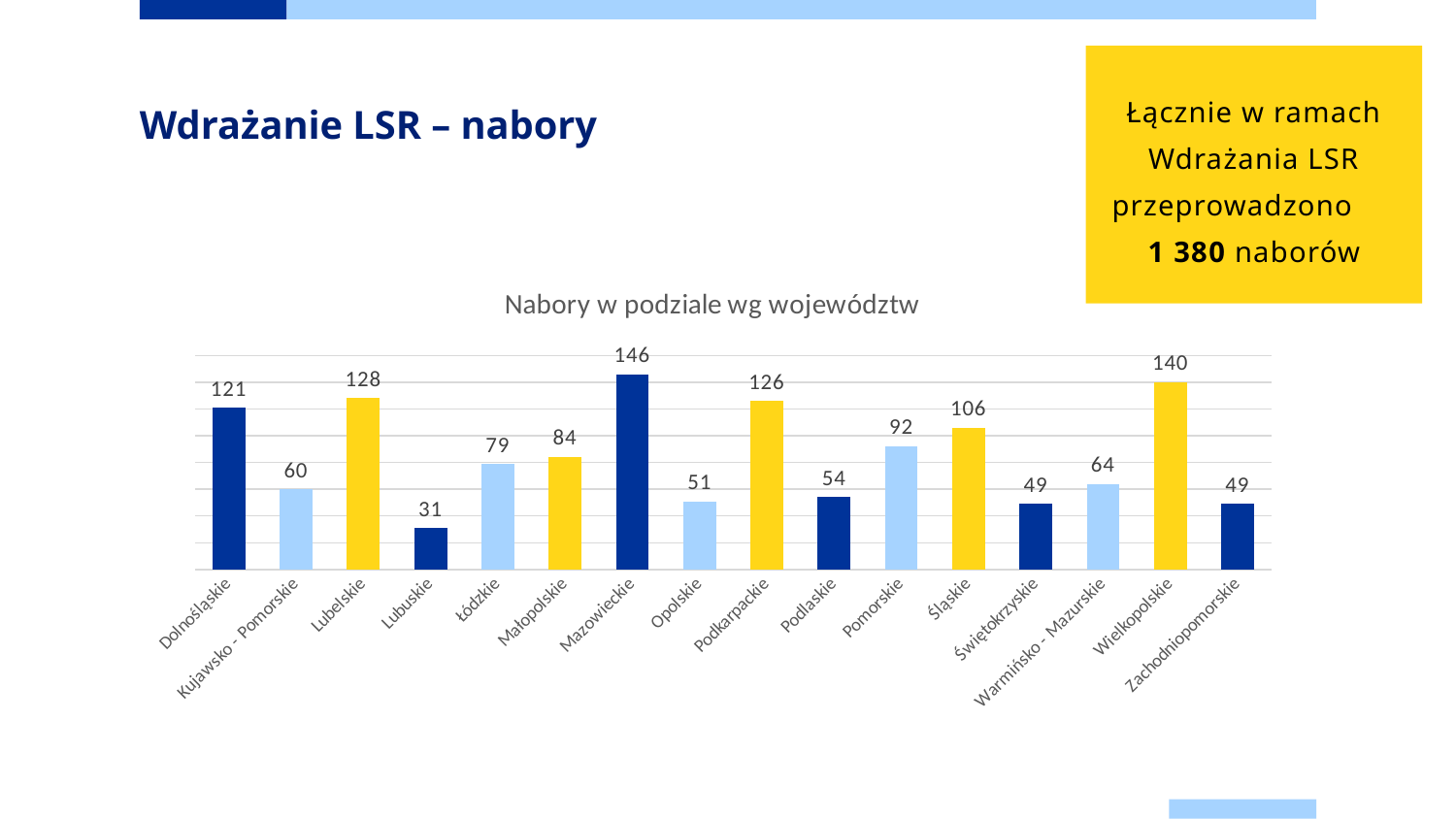
Which voivodeship has the lowest value? Lubuskie Which is larger, the value for Podkarpackie or the value for Dolnośląskie? Podkarpackie What is the value for Lubuskie? 31 What is the value for Śląskie? 106 What is the value for Mazowieckie? 146 How many voivodeships are shown on the x axis? 16 What kind of chart is shown? Bar chart What is the difference between the values for Mazowieckie and Lubuskie? 115 What is the difference between the values for Wielkopolskie and Lubelskie? 12 What is the title of the chart? Nabory w podziale wg województw What is the value for Pomorskie? 92 Which voivodeship has the highest value? Mazowieckie